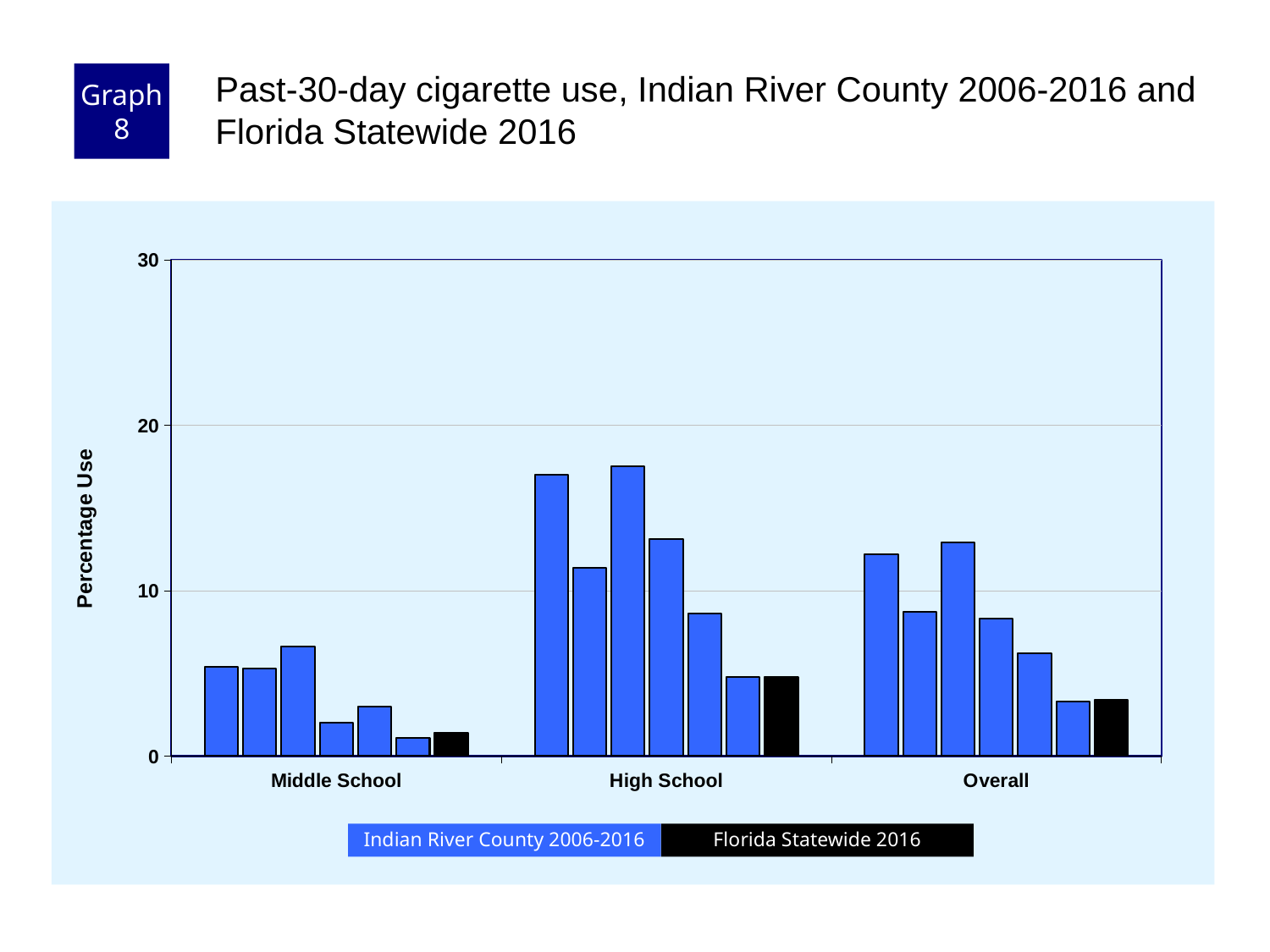
Which is larger, the Florida Statewide 2016 value for High School or for Middle School? High School What kind of chart is shown on the slide? bar chart Is the tallest High School bar greater or less than 10? greater Is the tallest High School bar greater or less than 20? less Which colour represents Florida Statewide 2016 in the legend? black How many series does the legend list? 2 What is the label on the y axis? Percentage Use How many category groups are shown along the x axis? 3 Which category group has the shortest bars? Middle School Is the tallest Middle School bar greater or less than 10? less Which category group has the tallest bars? High School